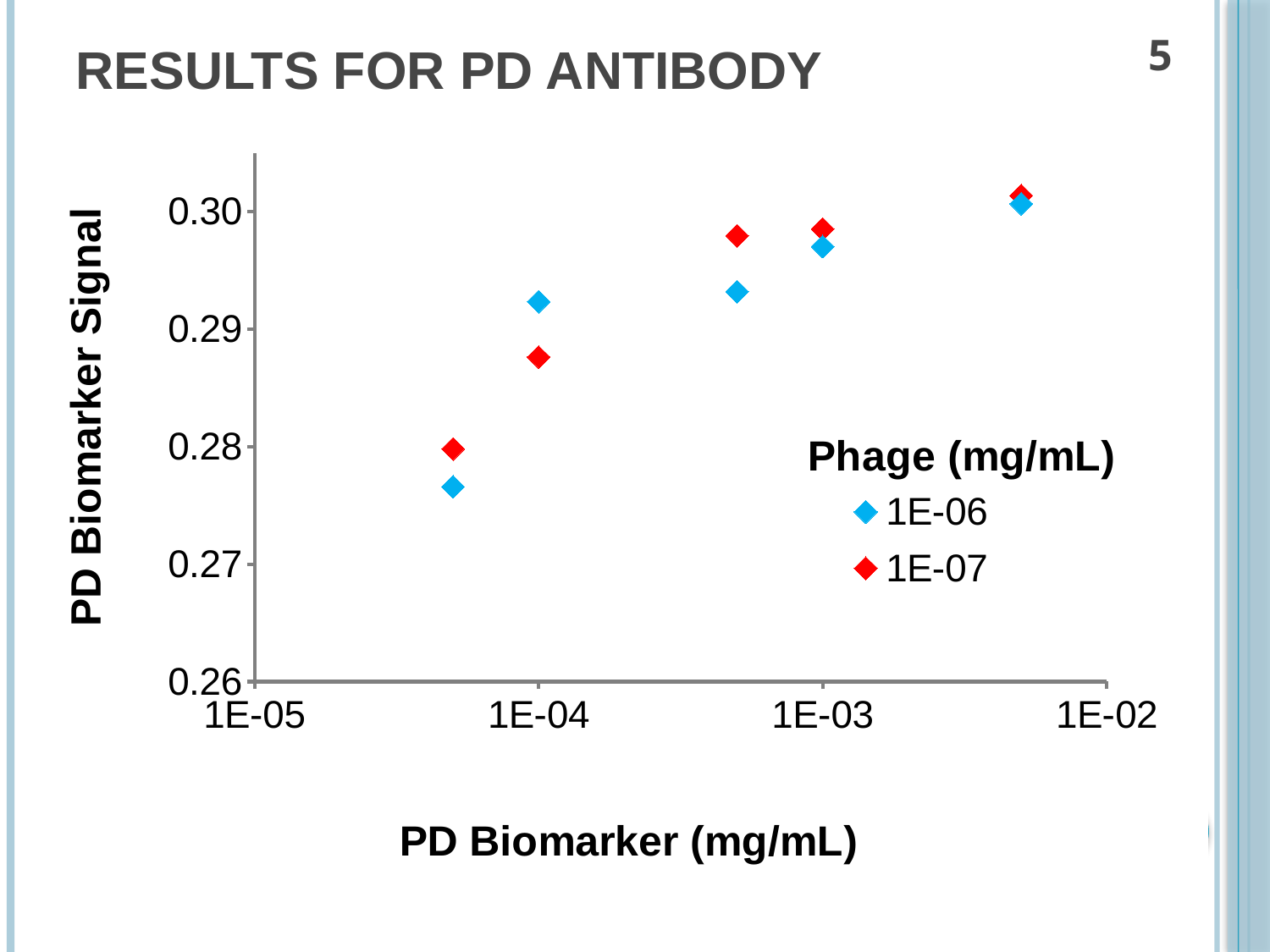
How many data points are plotted for the 1E-07 series? 5 At a PD Biomarker concentration of 1E-04 mg/mL, which series has the higher signal, 1E-06 or 1E-07? 1E-06 Which series contains the lowest point on the chart? 1E-06 What kind of chart is shown on the slide? Scatter chart Is the 1E-06 value at a PD Biomarker concentration of 1E-04 mg/mL greater or less than 0.29? greater What is the title of the legend? Phage (mg/mL) Is the lowest 1E-06 point on the chart greater or less than 0.28? less How many series does the legend list? 2 At a PD Biomarker concentration of 1E-03 mg/mL, which series has the higher signal, 1E-06 or 1E-07? 1E-07 How many data points are plotted for the 1E-06 series? 5 Do the PD Biomarker Signal values for the 1E-07 series rise or fall as PD Biomarker concentration increases? Rise Is the 1E-07 value at a PD Biomarker concentration of 1E-04 mg/mL greater or less than 0.29? less